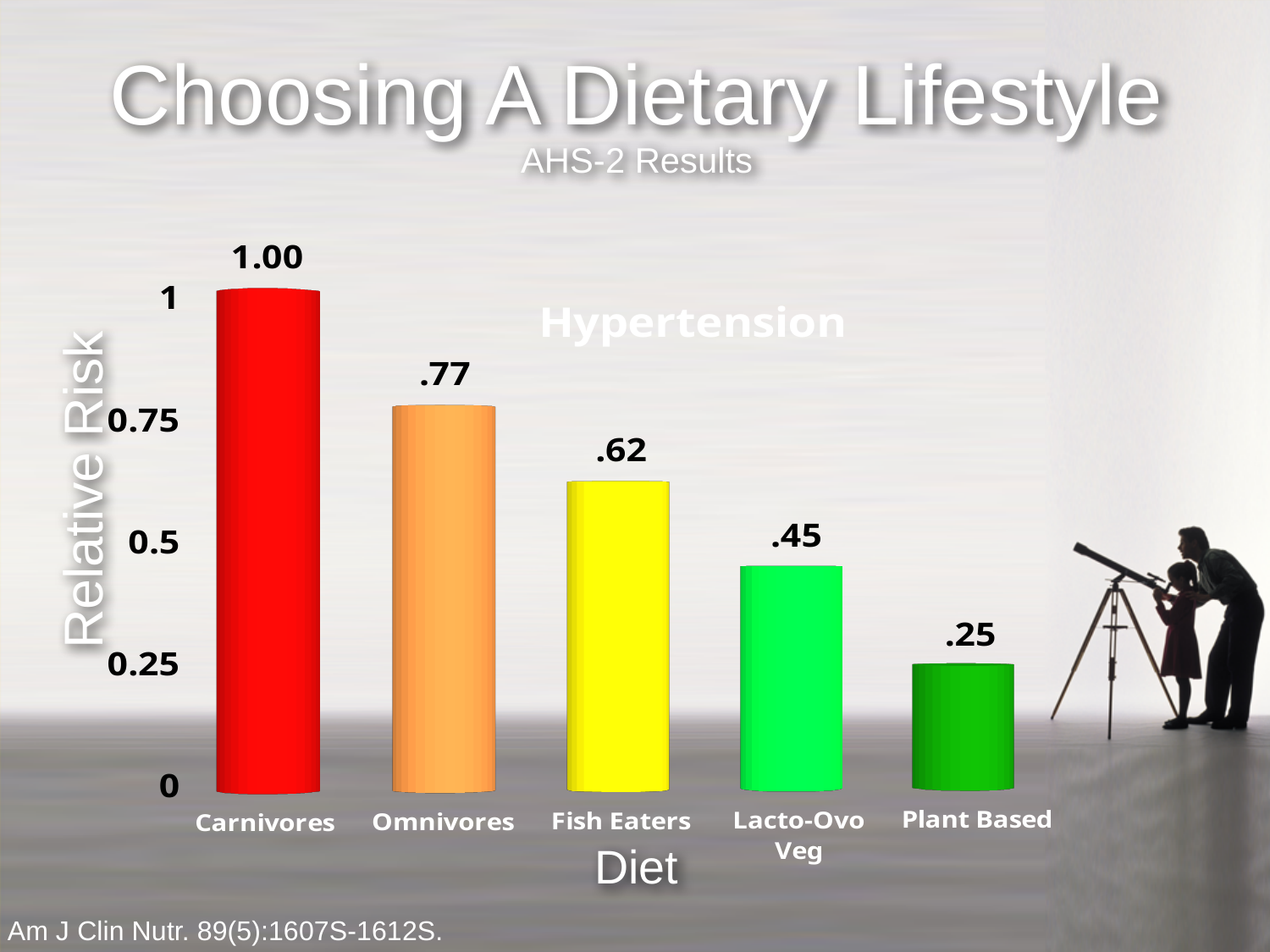
Do the relative risk values rise or fall from Carnivores to Plant Based along the x axis? Fall Which has a higher relative risk, Omnivores or Fish Eaters? Omnivores What is the relative risk of hypertension for Carnivores? 1.00 How many diet categories are shown in the chart? 5 What is the difference in relative risk between Carnivores and Plant Based? 0.75 Which diet has the lowest relative risk of hypertension? Plant Based What is the relative risk of hypertension for Plant Based? .25 Which diet has the highest relative risk of hypertension? Carnivores What is the relative risk of hypertension for Fish Eaters? .62 What kind of chart is shown on the slide? Bar chart What is the relative risk of hypertension for Omnivores? .77 What is the relative risk of hypertension for Lacto-Ovo Veg? .45